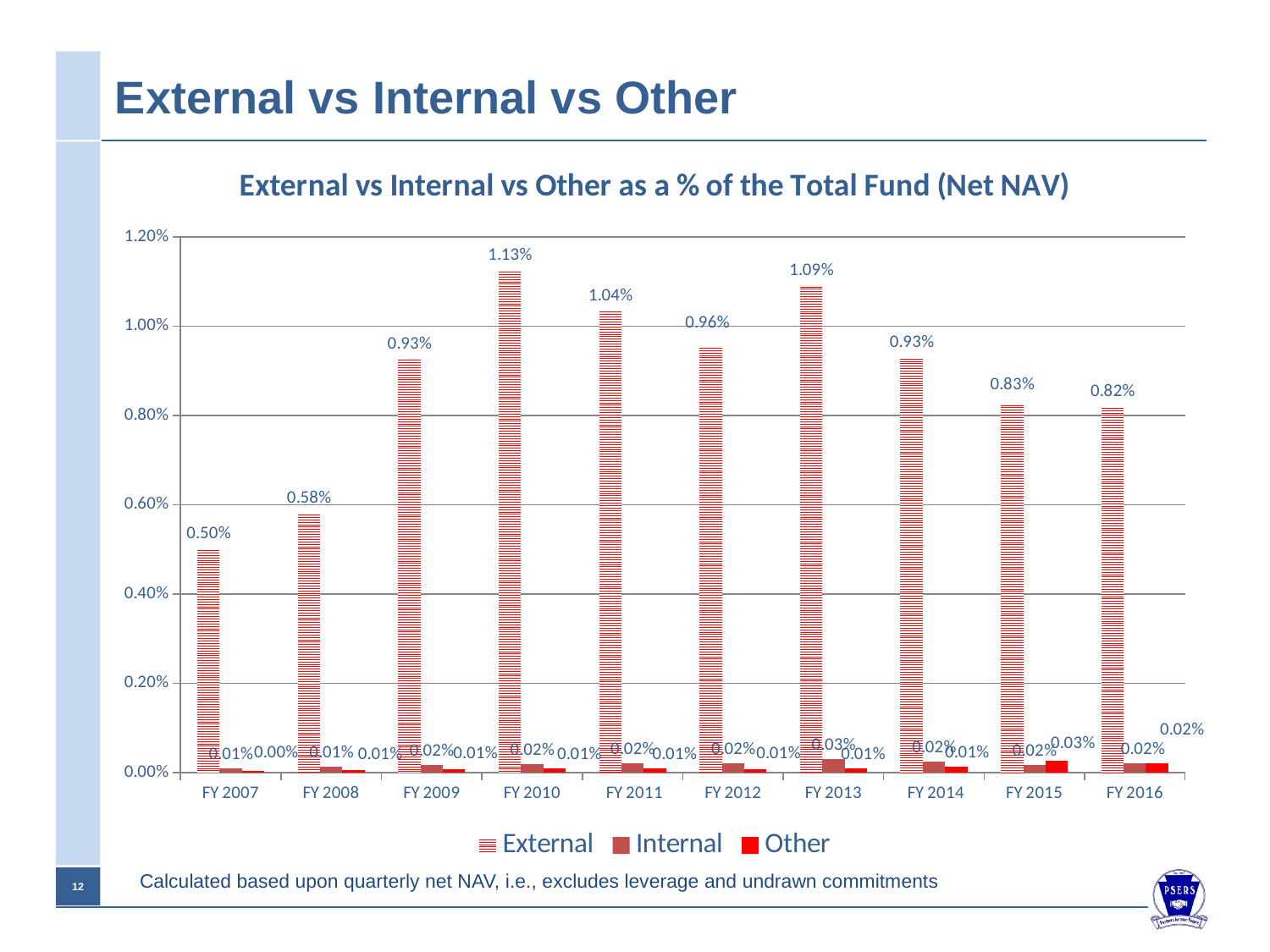
What is the difference between the External values for FY 2010 and FY 2007? 0.63% Which fiscal year has the lowest External value? FY 2007 What is the External value for FY 2010? 1.13% What is the Other value for FY 2015? 0.03% What is the External value for FY 2016? 0.82% Which fiscal year has the highest External value? FY 2010 What kind of chart is shown on the slide? Bar chart How many series does the legend list? 3 Which is larger, the External value for FY 2013 or for FY 2011? FY 2013 What is the External value for FY 2007? 0.50% Is the External value for FY 2012 greater or less than 0.80%? greater How many fiscal years are shown on the x axis? 10